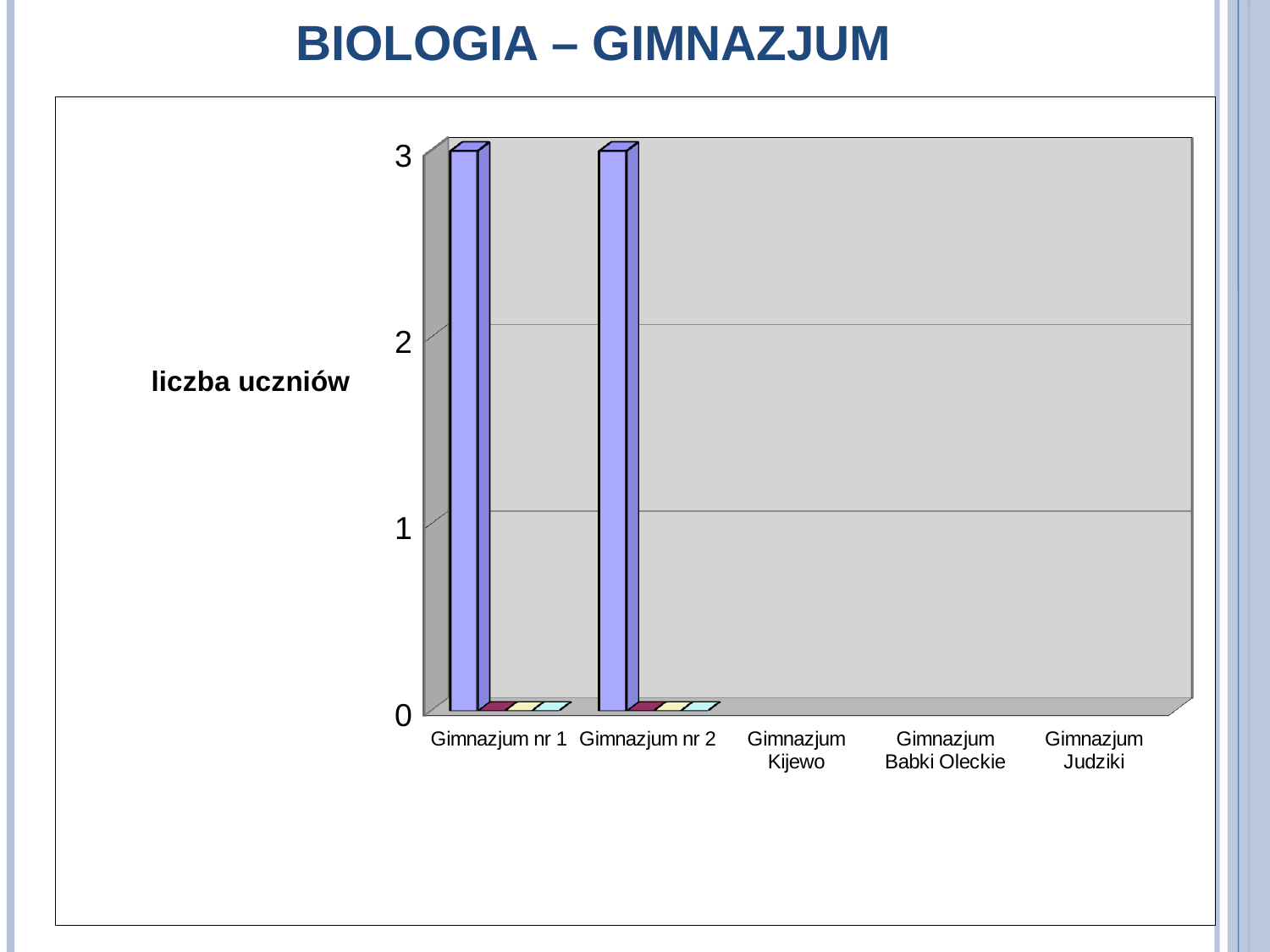
How many categories are shown on the x axis of the chart? 5 What is the label on the vertical axis of the chart? liczba uczniów Is the value for Gimnazjum nr 2 greater or less than 2? greater What kind of chart is shown on the slide? bar chart What is the title of the slide above the chart? BIOLOGIA – GIMNAZJUM What is the value (liczba uczniów) for Gimnazjum nr 1? 3 How many categories have a bar reaching 3? 2 What is the value (liczba uczniów) for Gimnazjum nr 2? 3 Which has the larger value, Gimnazjum nr 1 or Gimnazjum Babki Oleckie? Gimnazjum nr 1